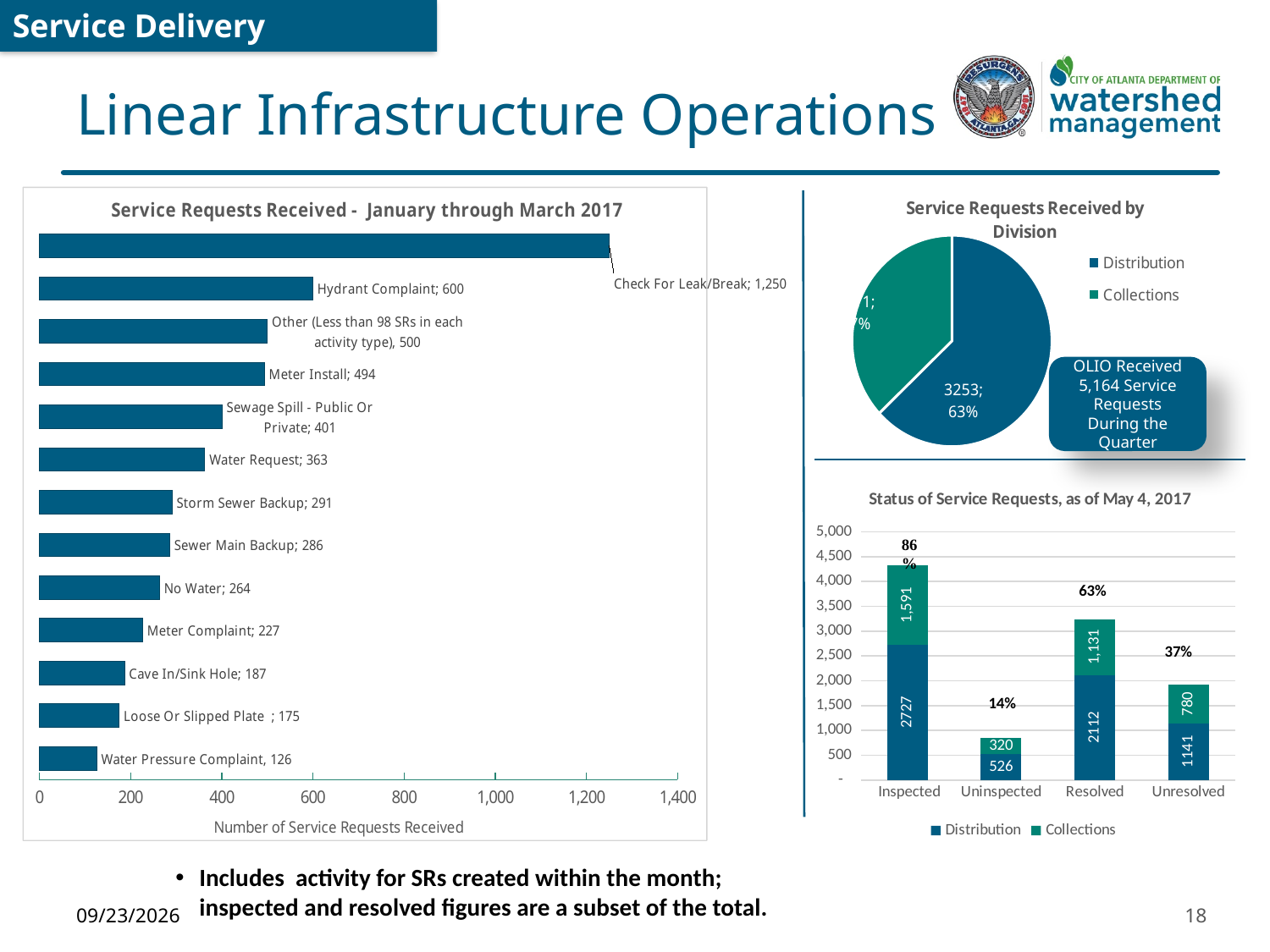
In the 'Service Requests Received - January through March 2017' chart, which activity type has the lowest number of service requests? Water Pressure Complaint In the 'Service Requests Received - January through March 2017' chart, how many service requests were received for Check For Leak/Break? 1,250 In the 'Service Requests Received - January through March 2017' chart, what is the difference between Hydrant Complaint and Meter Install? 106 In the 'Status of Service Requests, as of May 4, 2017' chart, how many series does the legend list? 2 In the 'Service Requests Received by Division' pie chart, what share of service requests came from Distribution? 63% In the 'Service Requests Received by Division' pie chart, how many service requests came from Distribution? 3253 In the 'Service Requests Received - January through March 2017' chart, which is larger: Storm Sewer Backup or No Water? Storm Sewer Backup In the 'Status of Service Requests, as of May 4, 2017' chart, what percentage is shown above the Unresolved bar? 37% In the 'Status of Service Requests, as of May 4, 2017' chart, what is the Collections value for Resolved? 1,131 What type of chart is 'Service Requests Received - January through March 2017'? Bar chart In the 'Service Requests Received - January through March 2017' chart, how many activity types are plotted? 13 In the 'Status of Service Requests, as of May 4, 2017' chart, what is the total of the Uninspected stacked bar? 846